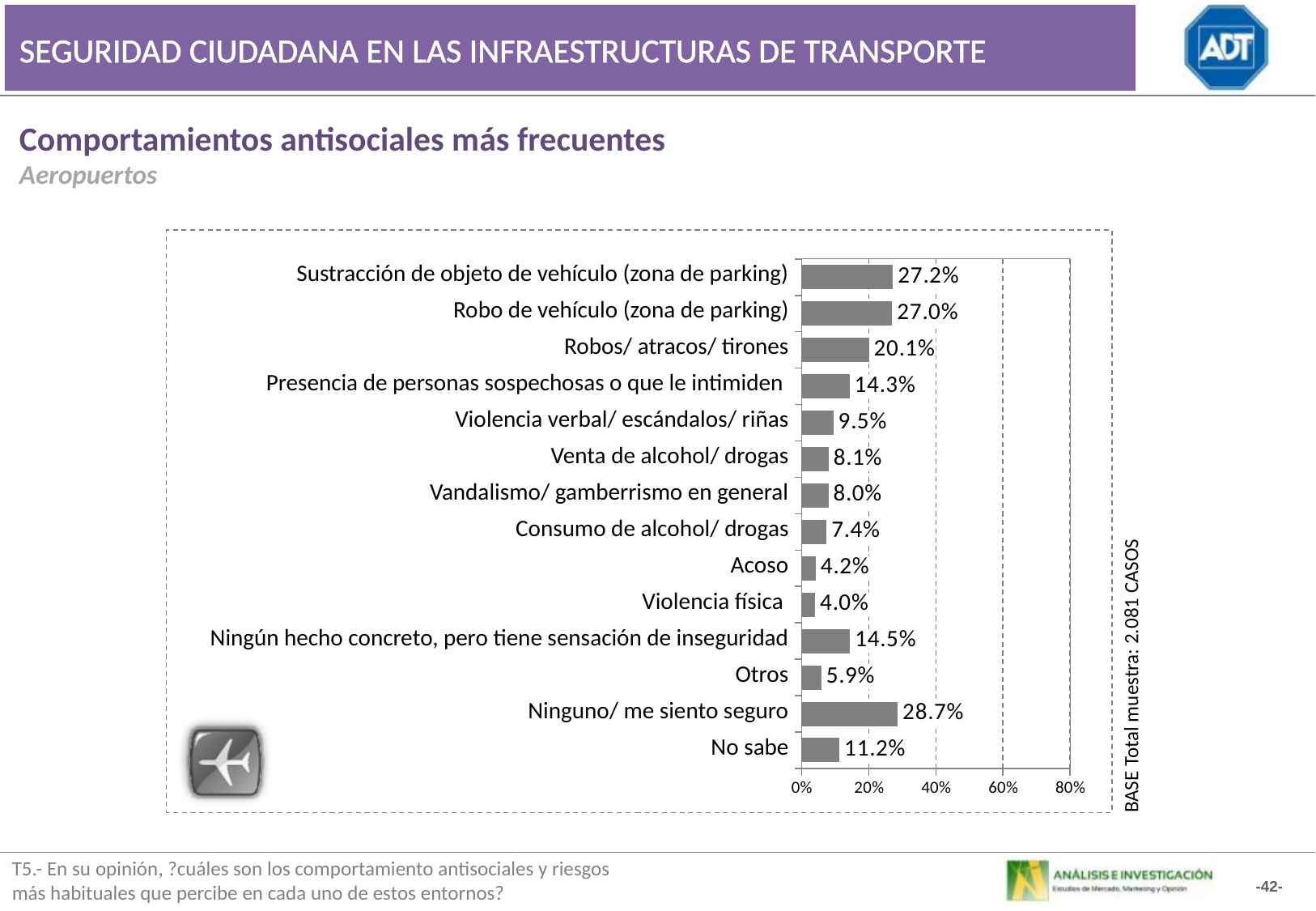
What is the value for "Acoso"? 4.2% What is the value for "No sabe"? 11.2% How many categories are shown in the chart? 14 What is the difference between "Sustracción de objeto de vehículo (zona de parking)" and "Robos/ atracos/ tirones"? 7.1% Is the value for "Ninguno/ me siento seguro" greater or less than 40%? less Which is larger: "Presencia de personas sospechosas o que le intimiden" or "Violencia verbal/ escándalos/ riñas"? Presencia de personas sospechosas o que le intimiden What is the value for "Ninguno/ me siento seguro"? 28.7% What is the base sample size stated next to the chart? 2.081 CASOS What kind of chart is shown on the slide? bar chart What is the value for "Robos/ atracos/ tirones"? 20.1% Which category has the lowest value? Violencia física Which category has the highest value? Ninguno/ me siento seguro